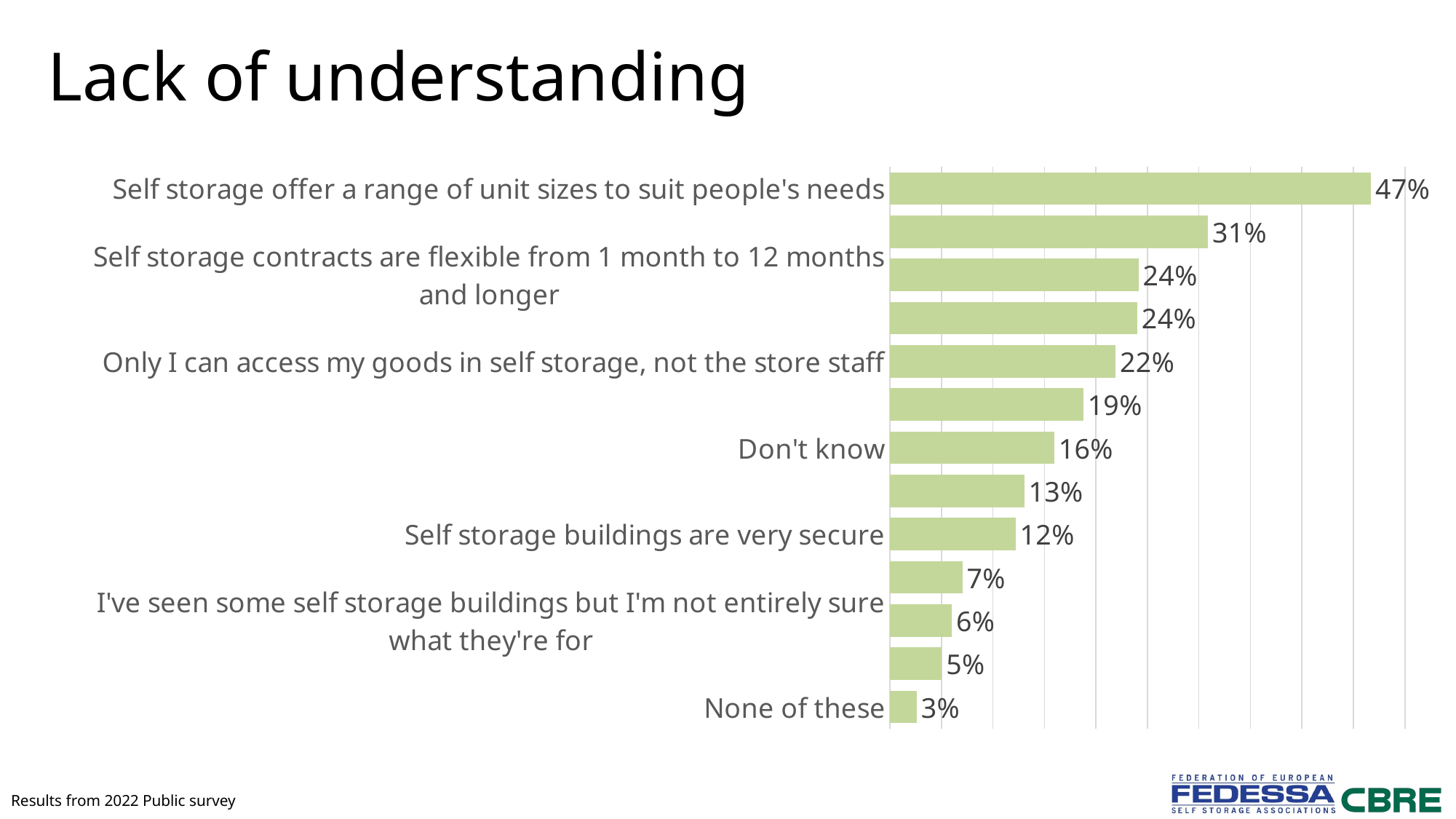
What is the value for "Self storage offer a range of unit sizes to suit people's needs"? 47% What is the value for "Don't know"? 16% Which is larger: the value for "Don't know" or the value for "Self storage buildings are very secure"? Don't know How many bars are plotted in the chart? 13 What is the value for "Self storage buildings are very secure"? 12% Which category has the highest value? Self storage offer a range of unit sizes to suit people's needs What is the title of the slide? Lack of understanding What kind of chart is shown on the slide? Bar chart What is the value for "Only I can access my goods in self storage, not the store staff"? 22% Which category has the lowest value? None of these What is the value for "None of these"? 3% What is the difference between the highest value (47%) and the value for "None of these" (3%)? 44 percentage points